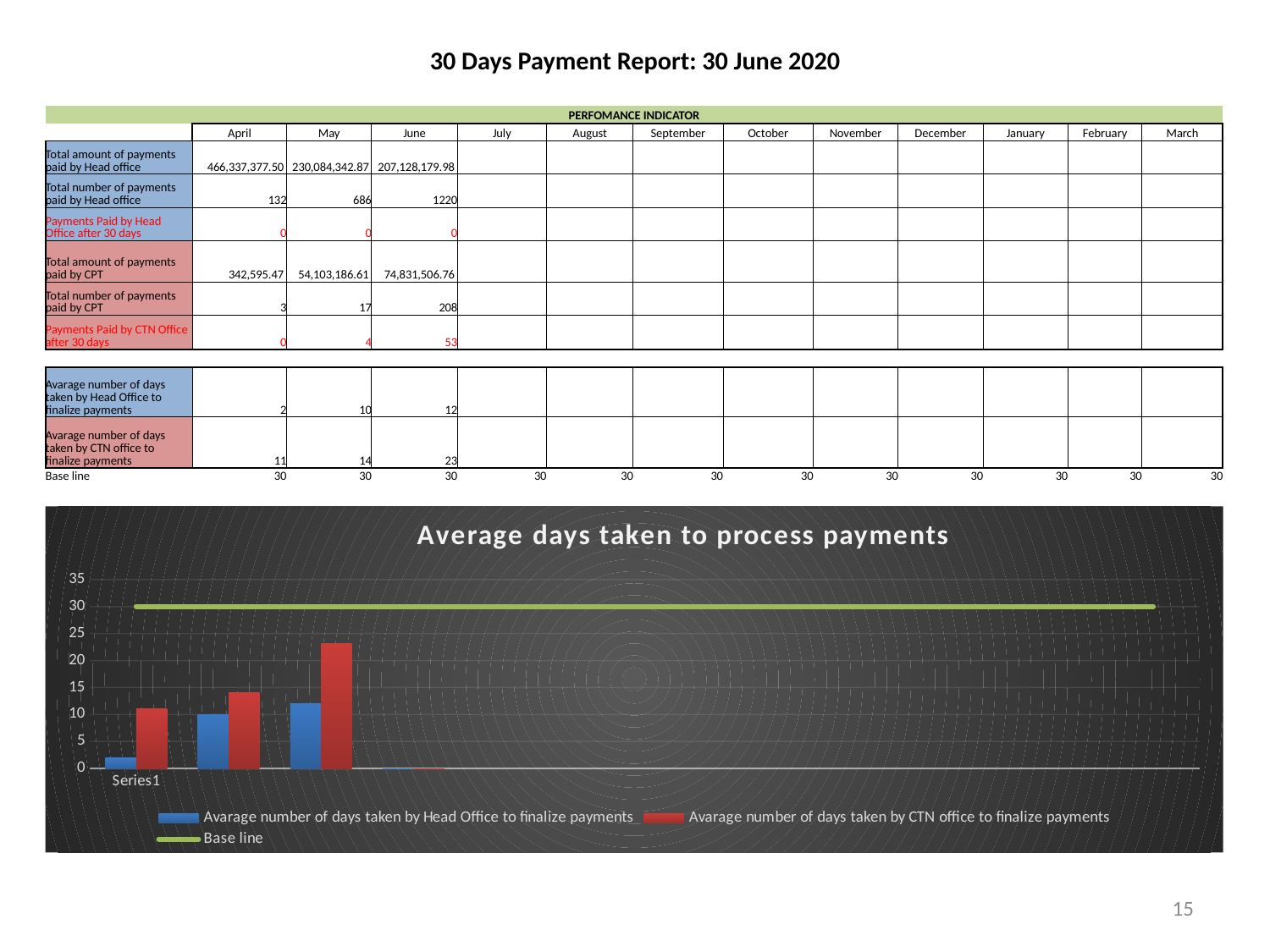
Is the value of the red (CTN office) bar in the third group greater or less than 20? greater Which group of bars has the tallest CTN office (red) bar? the third group What colour is the Base line on the chart? green How many series does the chart legend list? 3 Does any bar on the chart exceed the Base line? no Is the value of the blue (Head Office) bar in the third group greater or less than 15? less What is the title of the chart? Average days taken to process payments Is the value of the blue (Head Office) bar in the first group greater or less than 5? less Do the CTN office (red) bars rise or fall from left to right across the first three groups? rise What kind of chart is shown on the slide? combination bar and line chart At what value does the Base line sit on the chart? 30 In the first group of bars, which series has the larger value: Head Office or CTN office? CTN office